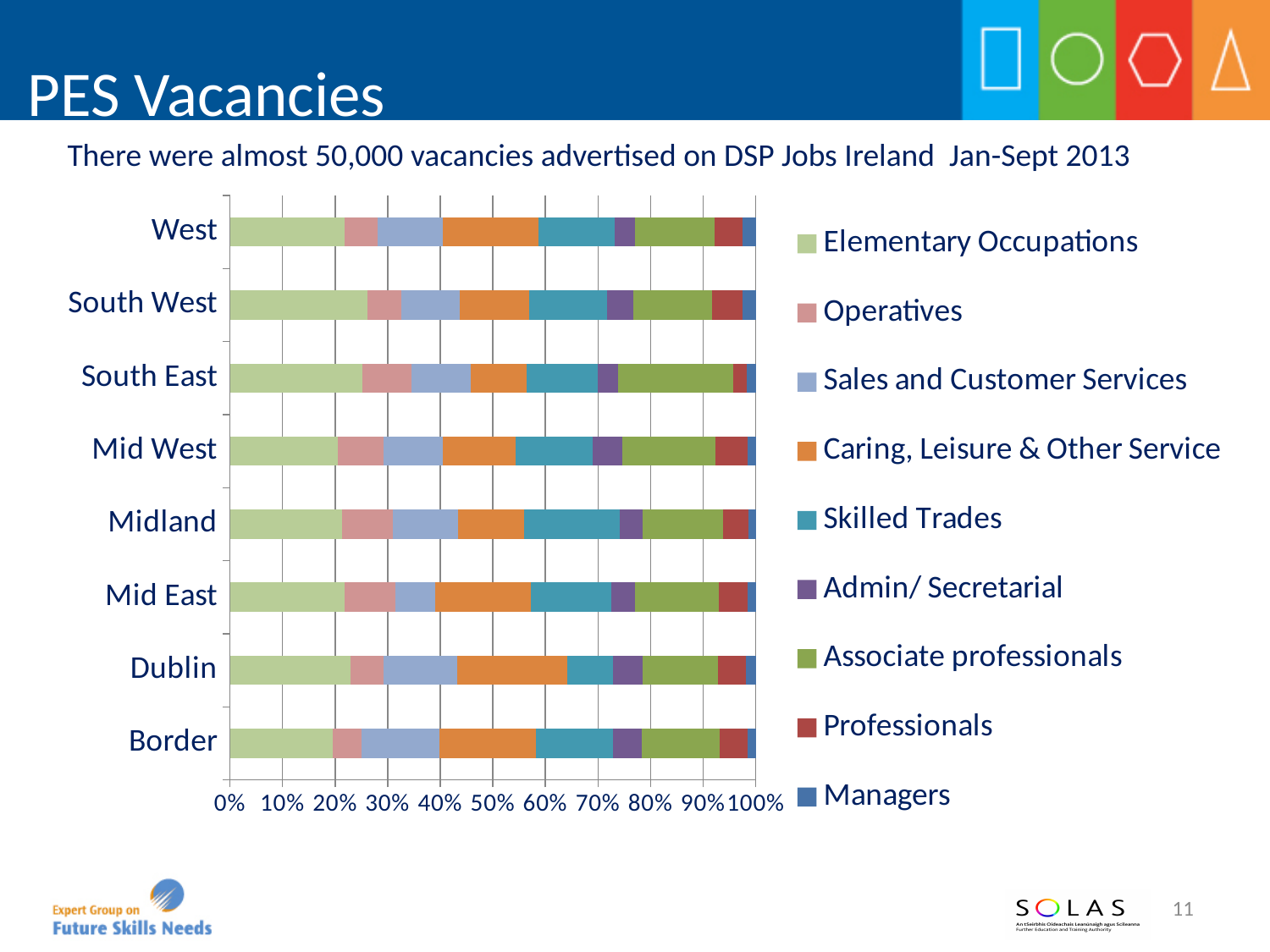
What is the highest value shown on the horizontal axis? 100% Which region is shown at the top of the chart? West Is the Caring, Leisure & Other Service share for Dublin greater or less than 10%? greater Is the Elementary Occupations share for South East greater or less than 20%? greater How many regions are listed on the vertical axis of the chart? 8 Is the Managers share for Dublin greater or less than 10%? less Which occupation category is listed first in the legend? Elementary Occupations What kind of chart is shown on the slide? stacked bar chart Which has the larger Elementary Occupations share, South East or Border? South East How many occupation categories does the legend list? 9 What value does each full stacked bar add up to on the horizontal axis? 100%